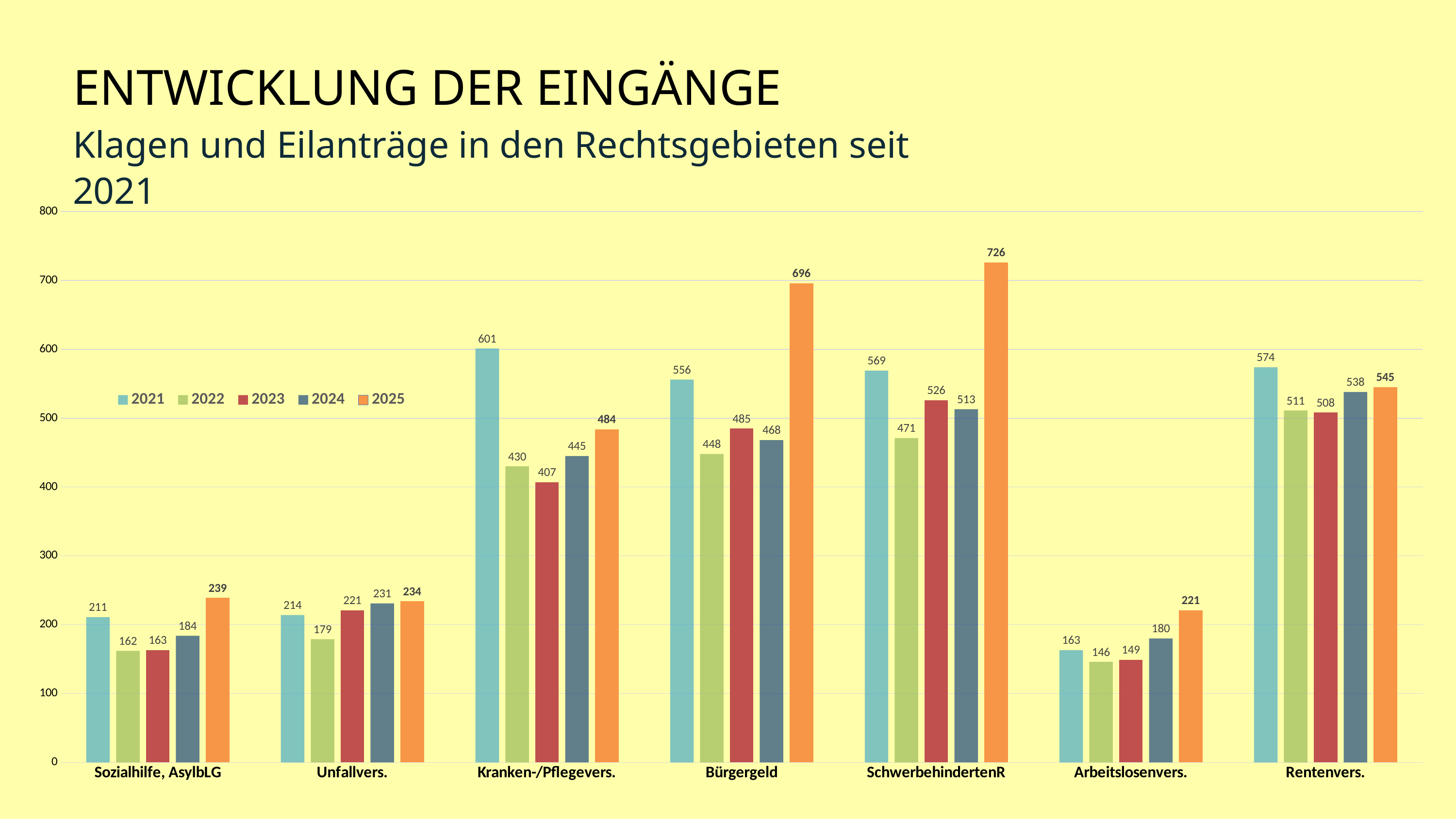
Do the values for Unfallvers. rise or fall from 2022 to 2025? Rise What is the value for Rentenvers. in 2021? 574 How many categories are shown on the x axis? 7 What kind of chart is shown on the slide? Bar chart What is the value for Bürgergeld in 2025? 696 What is the value for Arbeitslosenvers. in 2022? 146 Which is larger: the 2024 value for Bürgergeld or the 2024 value for SchwerbehindertenR? SchwerbehindertenR Which category has the lowest value in 2023? Arbeitslosenvers. What is the difference between the 2021 and 2025 values for Kranken-/Pflegevers.? 117 Which year is shown in orange in the legend? 2025 How many series does the legend list? 5 Which category has the highest value in 2025? SchwerbehindertenR